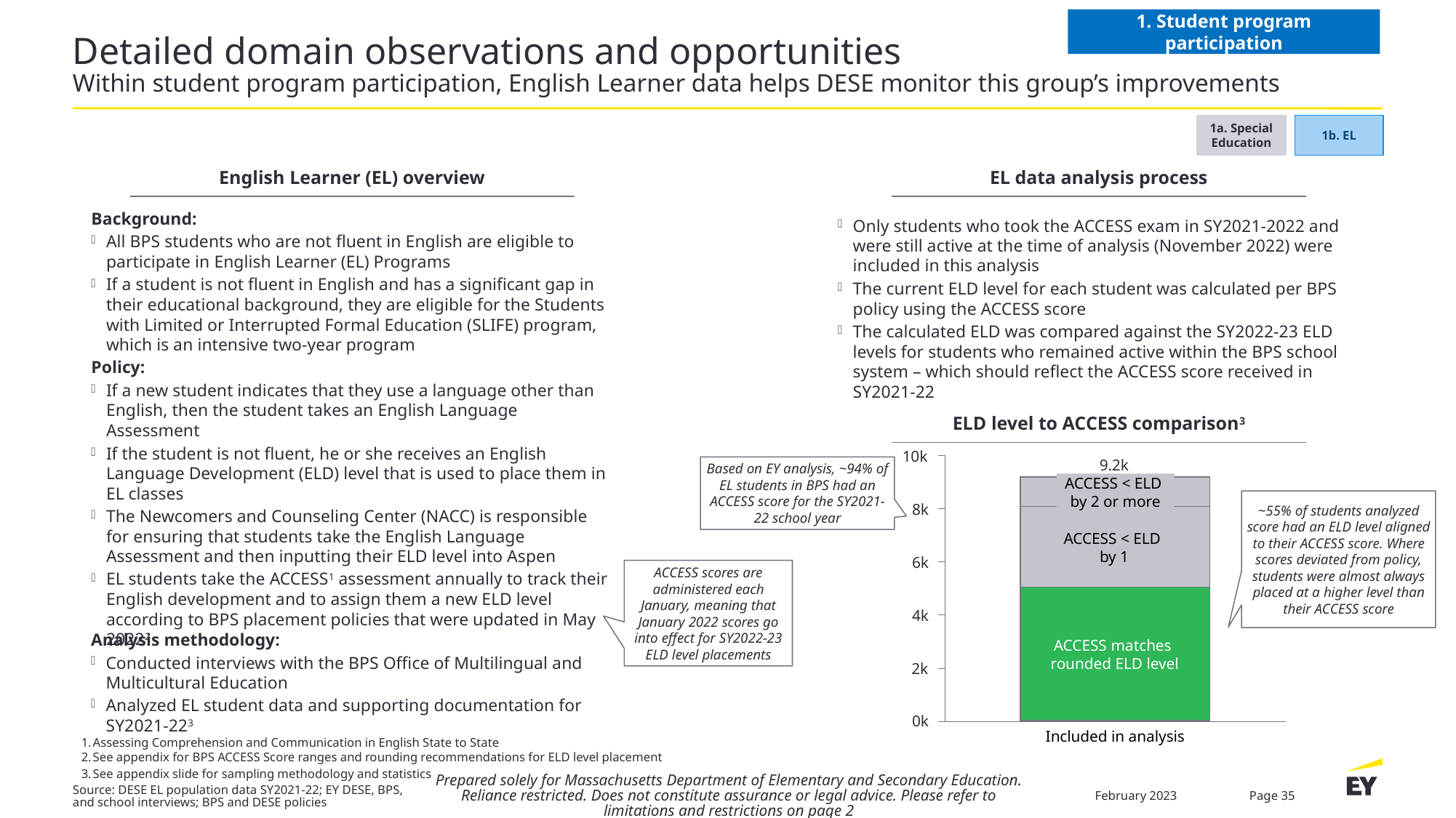
Which segment is the smallest in the stacked bar of the 'ELD level to ACCESS comparison' chart? ACCESS < ELD by 2 or more What is the total value shown on top of the stacked bar in the 'ELD level to ACCESS comparison' chart? 9.2k What is the title of the chart on the slide? ELD level to ACCESS comparison In the 'ELD level to ACCESS comparison' chart, is the total of the stacked bar greater or less than 10k? less What kind of chart is the 'ELD level to ACCESS comparison' chart? Stacked bar chart How many segments make up the stacked bar in the 'ELD level to ACCESS comparison' chart? 3 In the 'ELD level to ACCESS comparison' chart, is the total of the stacked bar greater or less than 8k? greater In the 'ELD level to ACCESS comparison' chart, is the 'ACCESS matches rounded ELD level' segment greater or less than 4k? greater Which segment of the stacked bar in the 'ELD level to ACCESS comparison' chart is coloured green? ACCESS matches rounded ELD level Which segment is the largest in the stacked bar of the 'ELD level to ACCESS comparison' chart? ACCESS matches rounded ELD level In the 'ELD level to ACCESS comparison' chart, which segment is larger: 'ACCESS < ELD by 1' or 'ACCESS < ELD by 2 or more'? ACCESS < ELD by 1 How many bars are plotted in the 'ELD level to ACCESS comparison' chart? 1